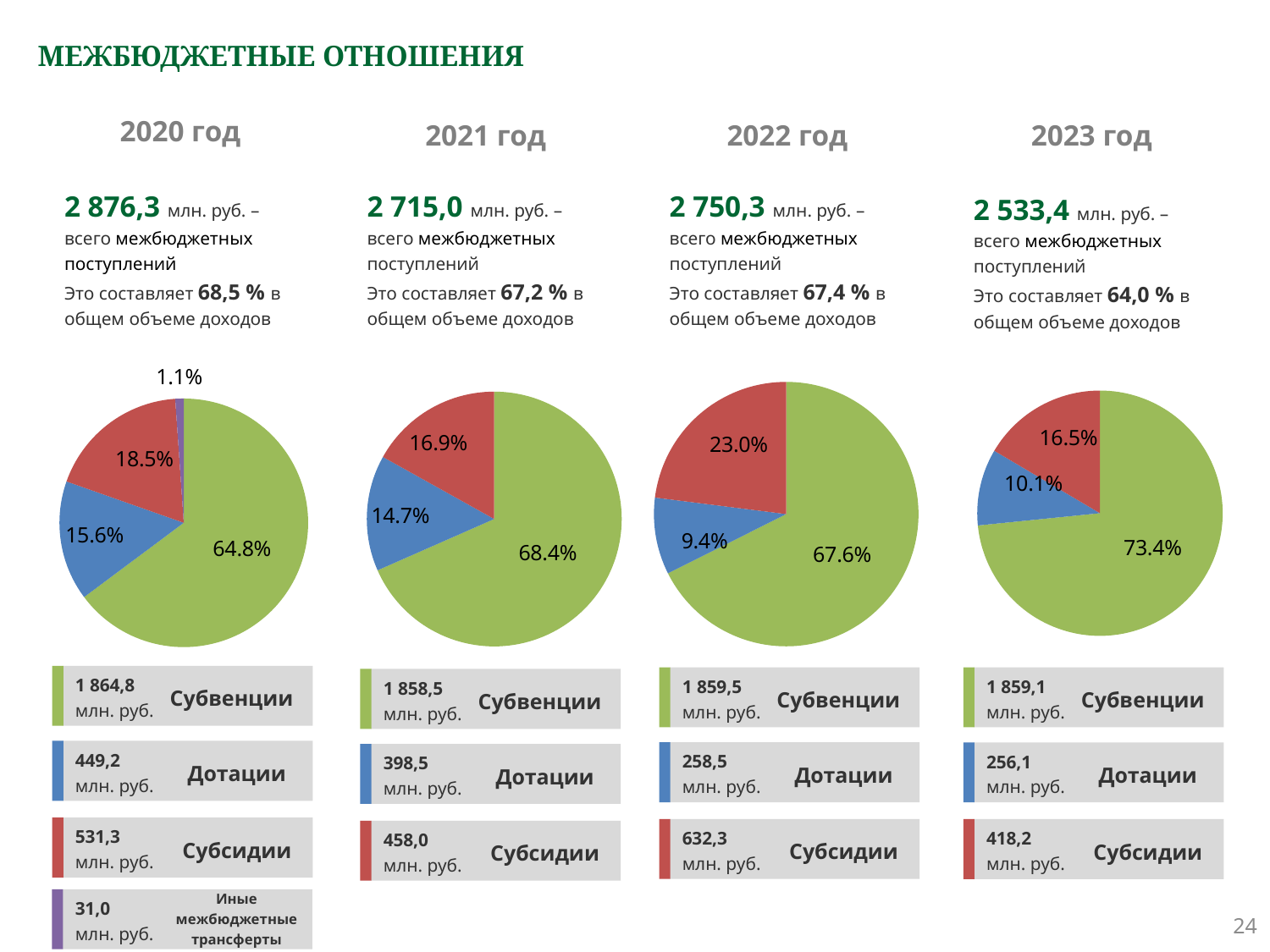
How many slices does the 2023 год pie chart have? 3 In the 2022 год pie chart, what share is shown for Субсидии? 23.0% How many slices does the 2020 год pie chart have? 4 In the 2021 год pie chart, what share is shown for Дотации? 14.7% In the 2021 год pie chart, which is larger: the share for Субсидии or the share for Дотации? Субсидии What kind of chart is used for the 2022 год data? Pie chart In the 2020 год pie chart, which category has the smallest share? Иные межбюджетные трансферты In the 2023 год pie chart, what is the difference between the share for Субсидии and the share for Дотации? 6.4 percentage points In the 2022 год pie chart, which category has the largest share? Субвенции In the 2020 год pie chart, what share is shown for Субвенции? 64.8% In the 2022 год chart legend, what value is given for Дотации? 258,5 млн. руб.